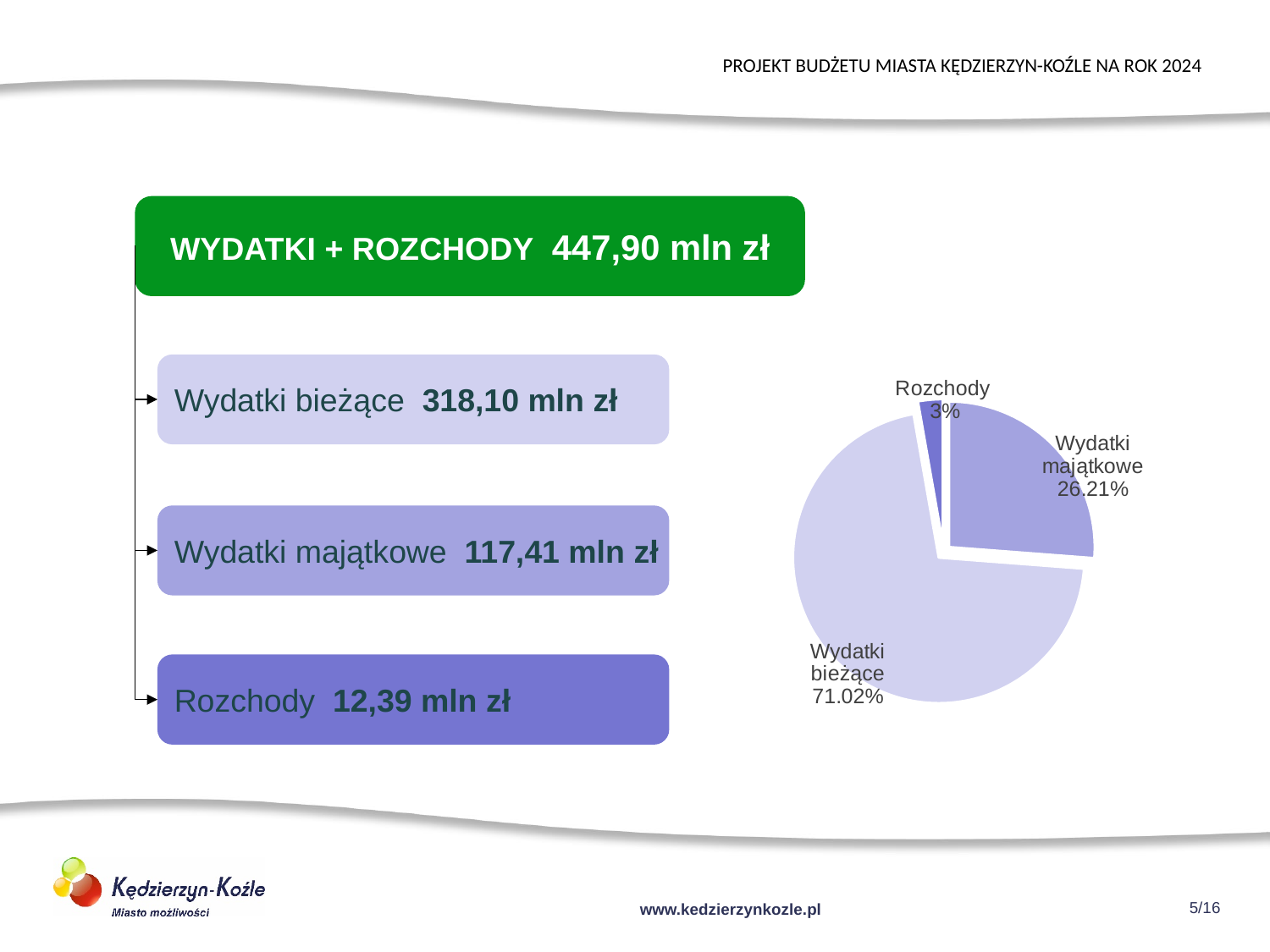
How many slices does the pie chart have? 3 In the pie chart, what is the difference in percentage points between Wydatki majątkowe and Rozchody? 23.21 What share of the pie chart is labelled for Wydatki bieżące? 71.02% Which slice of the pie chart is drawn in the lightest shade? Wydatki bieżące What kind of chart is shown on the slide? pie chart Which slice of the pie chart is the largest? Wydatki bieżące In the pie chart, which is larger: Wydatki majątkowe or Rozchody? Wydatki majątkowe What share of the pie chart is labelled for Rozchody? 3% Which slice of the pie chart is drawn in the darkest shade of purple? Rozchody In the pie chart, what is the difference in percentage points between Wydatki bieżące and Wydatki majątkowe? 44.81 What share of the pie chart is labelled for Wydatki majątkowe? 26.21% Which slice of the pie chart is the smallest? Rozchody